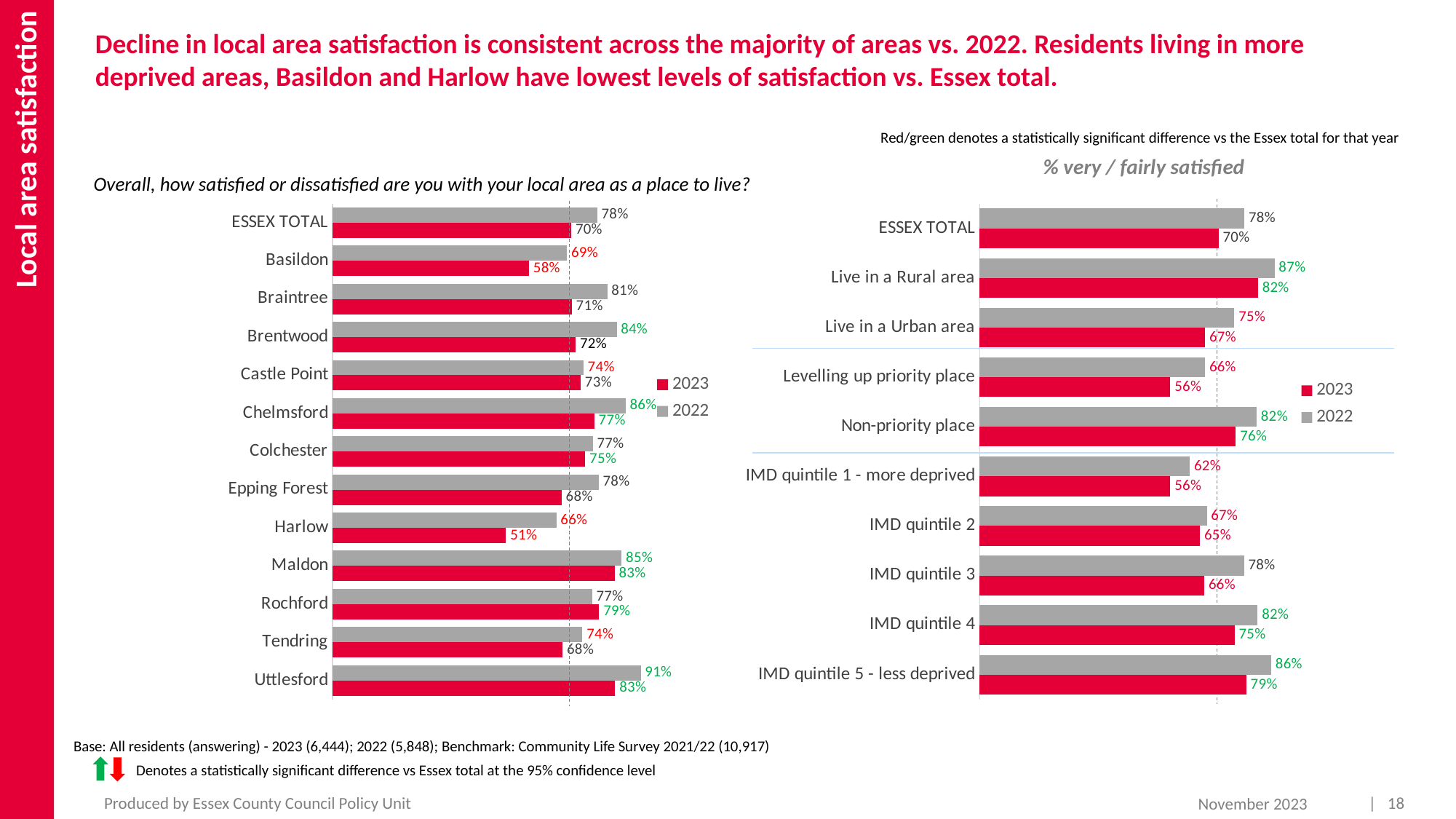
In the right chart, which category has the lowest 2022 value? IMD quintile 1 - more deprived In the left chart, what is the 2023 value for Harlow? 51% In the left chart, which area has the highest 2022 value? Uttlesford In the right chart, which has the larger 2023 value: IMD quintile 4 or IMD quintile 5 - less deprived? IMD quintile 5 - less deprived In the left chart, what is the difference between the 2022 and 2023 values for Basildon? 11 percentage points How many series does the legend of the left chart list? 2 In the right chart, what is the 2022 value for Live in a Rural area? 87% In the left chart, how many areas are listed? 13 In the left chart, what is the 2023 value for Rochford? 79% What type of chart is the right chart? Bar chart In the left chart, which area has the lowest 2023 value? Harlow In the right chart, what is the difference between the 2022 and 2023 values for ESSEX TOTAL? 8 percentage points